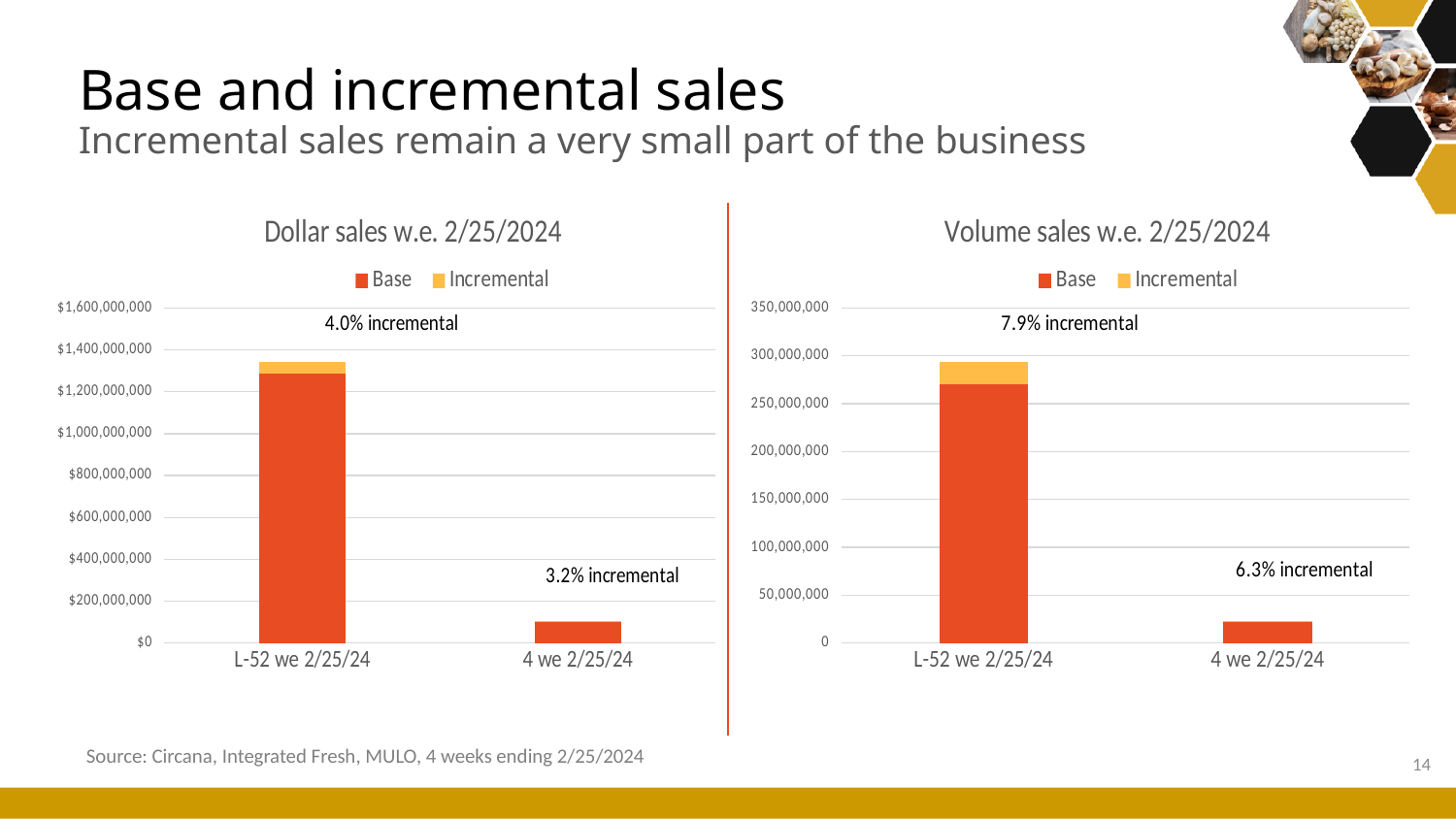
How many series does the legend of the "Volume sales w.e. 2/25/2024" chart list? 2 In the "Volume sales w.e. 2/25/2024" chart, is the total bar for L-52 we 2/25/24 greater or less than 250,000,000? greater In the "Dollar sales w.e. 2/25/2024" chart, what incremental percentage is labelled for 4 we 2/25/24? 3.2% incremental In the "Volume sales w.e. 2/25/2024" chart, what incremental percentage is labelled for 4 we 2/25/24? 6.3% incremental In the "Volume sales w.e. 2/25/2024" chart, which category has the taller bar, L-52 we 2/25/24 or 4 we 2/25/24? L-52 we 2/25/24 In the "Dollar sales w.e. 2/25/2024" chart, is the total bar for L-52 we 2/25/24 greater or less than $1,200,000,000? greater What are the two series named in the legend of the "Dollar sales w.e. 2/25/2024" chart? Base and Incremental How many categories are shown on the x axis of the "Volume sales w.e. 2/25/2024" chart? 2 What kind of chart is the "Dollar sales w.e. 2/25/2024" chart? Stacked bar chart In the "Dollar sales w.e. 2/25/2024" chart, is the bar for 4 we 2/25/24 greater or less than $200,000,000? less In the "Dollar sales w.e. 2/25/2024" chart, what incremental percentage is labelled for L-52 we 2/25/24? 4.0% incremental In the "Volume sales w.e. 2/25/2024" chart, what incremental percentage is labelled for L-52 we 2/25/24? 7.9% incremental